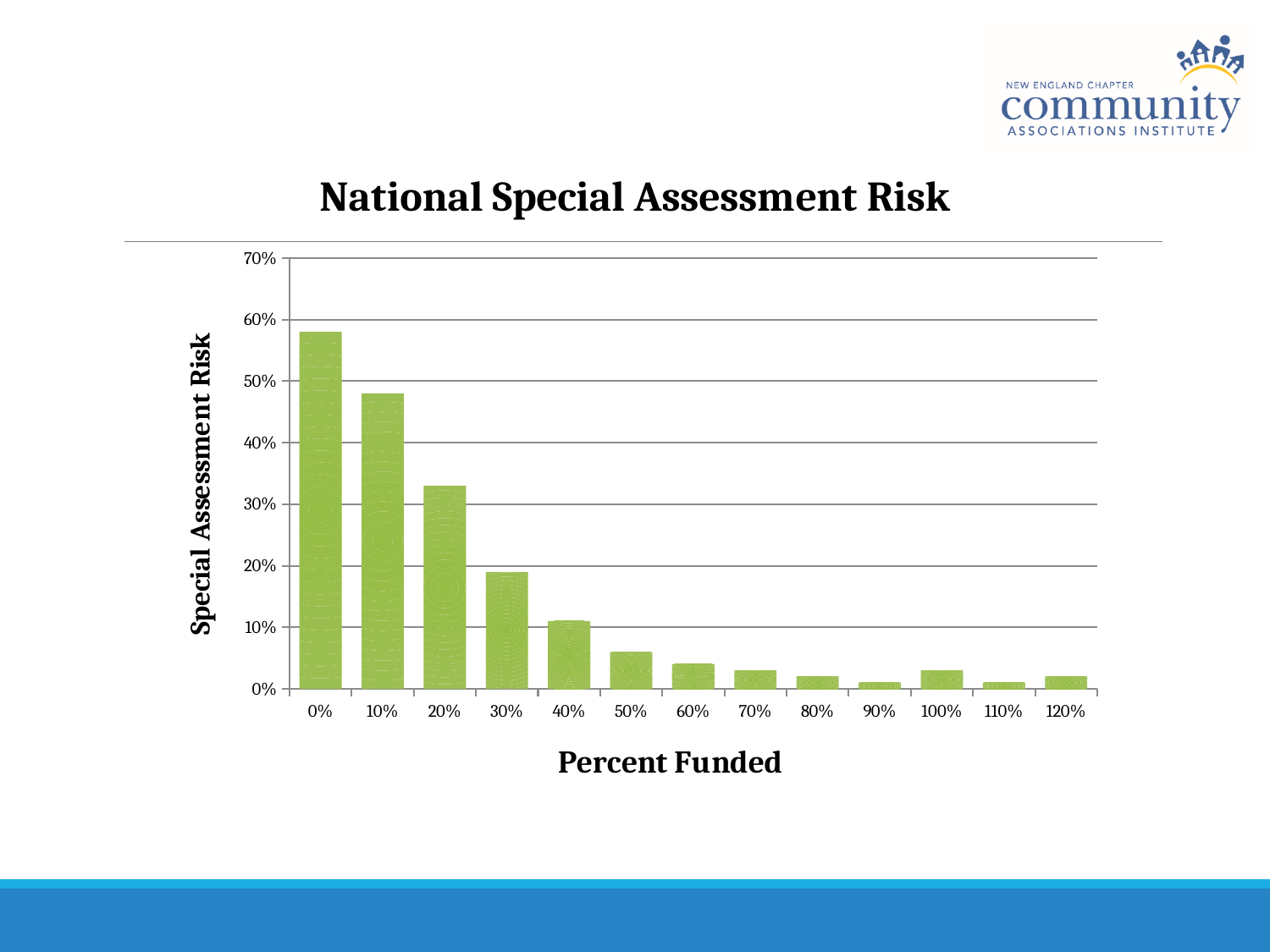
Is the Special Assessment Risk for 30% Percent Funded greater or less than 10%? greater What is the title of the chart? National Special Assessment Risk Which Percent Funded category has the highest Special Assessment Risk? 0% Is the Special Assessment Risk for 0% Percent Funded greater or less than 50%? greater How many Percent Funded categories are shown on the x axis? 13 Does the Special Assessment Risk generally rise or fall as Percent Funded increases from 0% to 50%? fall Which has a higher Special Assessment Risk: 10% Percent Funded or 20% Percent Funded? 10% Which has a higher Special Assessment Risk: 40% Percent Funded or 100% Percent Funded? 40% What kind of chart is shown on the slide? bar chart Is the Special Assessment Risk for 50% Percent Funded greater or less than 10%? less